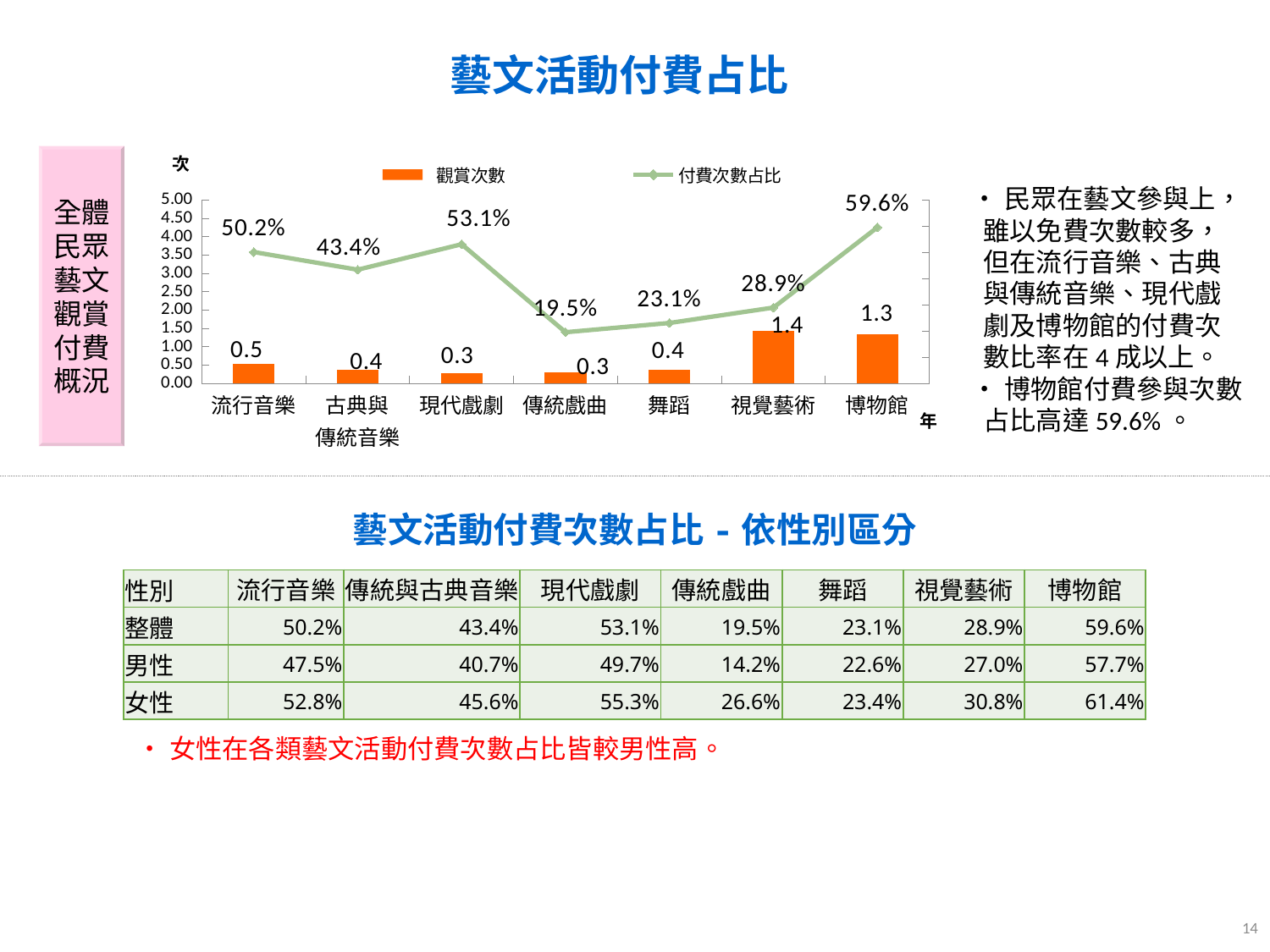
In the chart, what is the 觀賞次數 value for 視覺藝術? 1.4 Which has a higher 付費次數占比, 流行音樂 or 古典與傳統音樂? 流行音樂 Which category has the highest 觀賞次數 bar in the chart? 視覺藝術 How many series does the chart legend list? 2 What is the difference between the 付費次數占比 of 博物館 and 傳統戲曲? 40.1 percentage points How many categories are shown on the x axis of the chart? 7 Does the 付費次數占比 line rise or fall from 現代戲劇 to 傳統戲曲? Fall In the chart, what is the 付費次數占比 value for 舞蹈? 23.1% Which category has the lowest 付費次數占比 in the chart? 傳統戲曲 In the chart, what is the 付費次數占比 value for 博物館? 59.6% What kind of chart is shown on the slide? A bar chart combined with a line chart Which category has the highest 付費次數占比 in the chart? 博物館